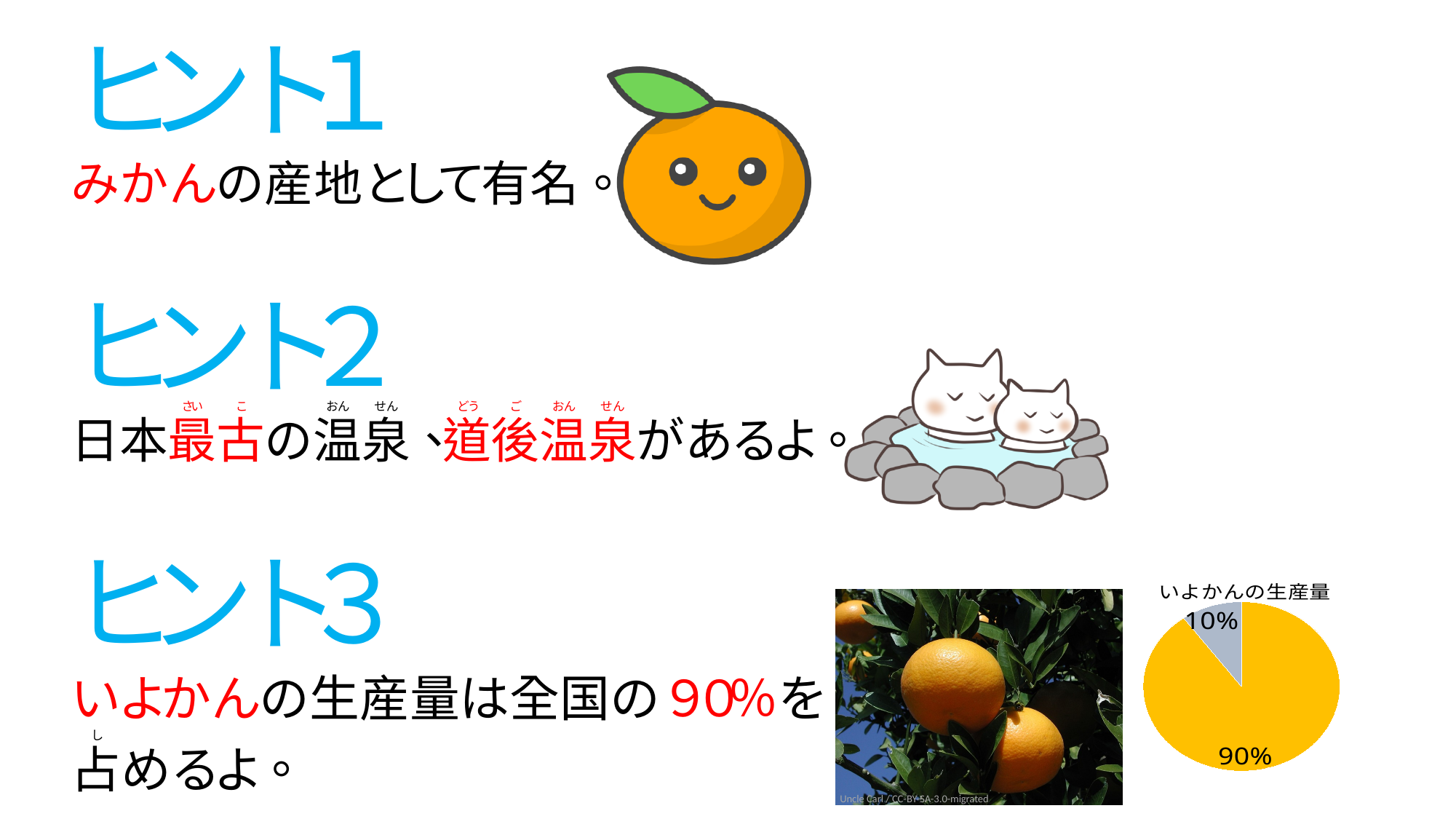
What share of the pie does the larger slice represent? 90% What is the difference between the two slices of the pie chart? 80% What percentage is shown on the gray slice of the pie chart? 10% What kind of chart is shown on the slide? pie chart Is the yellow slice or the gray slice of the pie chart larger? the yellow slice What colour is the slice labelled 10% in the pie chart? gray How many slices does the pie chart have? 2 Which slice of the pie chart is the largest? the yellow slice (90%) Which slice of the pie chart is the smallest? the gray slice (10%) What percentage is shown on the yellow slice of the pie chart? 90% What is the title of the pie chart? いよかんの生産量